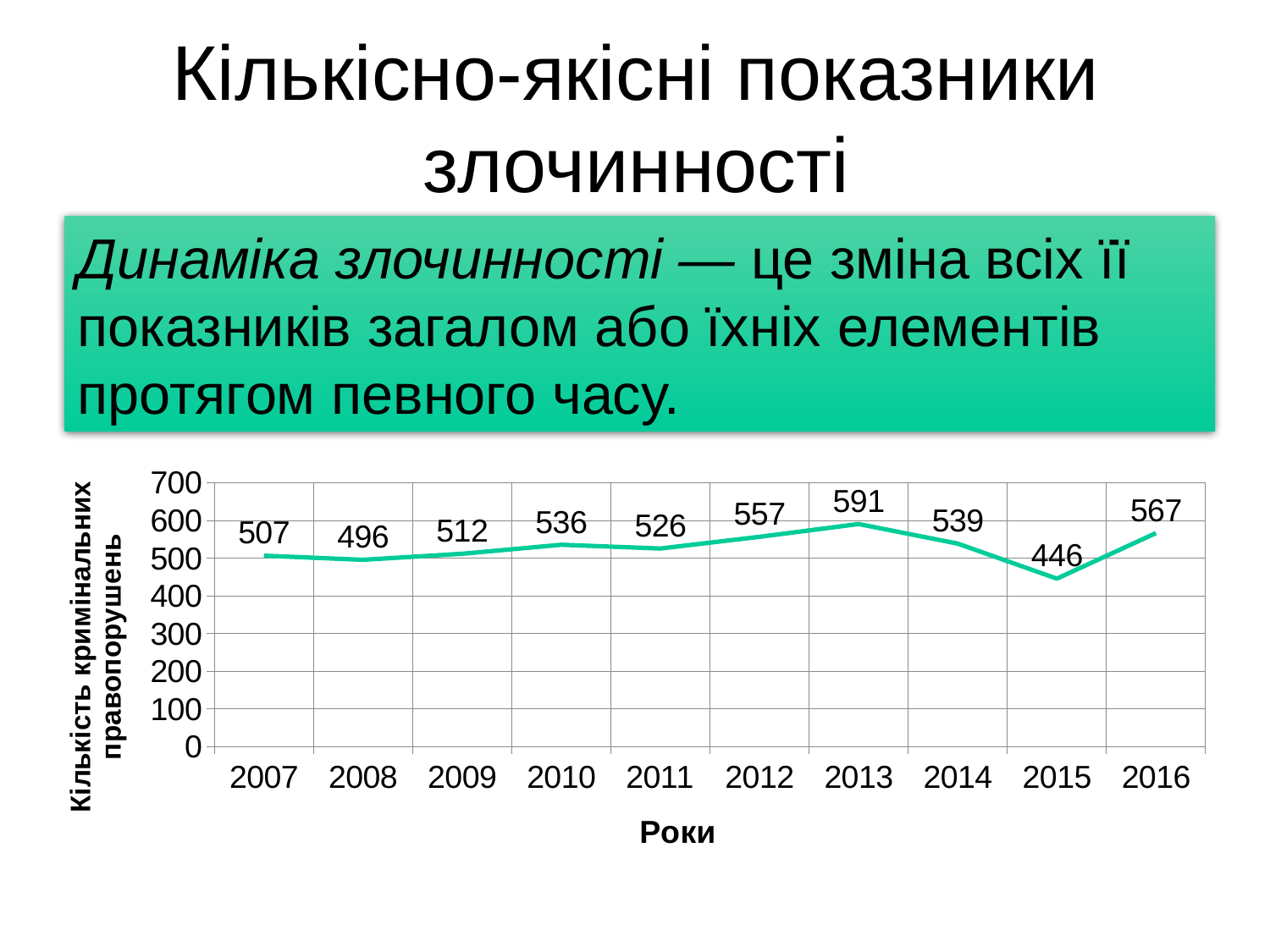
Which year has the highest number of criminal offences? 2013 What is the number of criminal offences shown for 2013? 591 What is the label of the horizontal axis of the chart? Роки Is the value for 2015 greater or less than 500? less Which year has the lowest number of criminal offences? 2015 How many years are plotted on the chart? 10 Which year has a larger value, 2010 or 2011? 2010 By how much does the value for 2016 exceed the value for 2015? 121 What is the difference between the values for 2013 and 2015? 145 What is the value for 2016? 567 What kind of chart is shown on the slide? line chart What value is plotted for 2008? 496